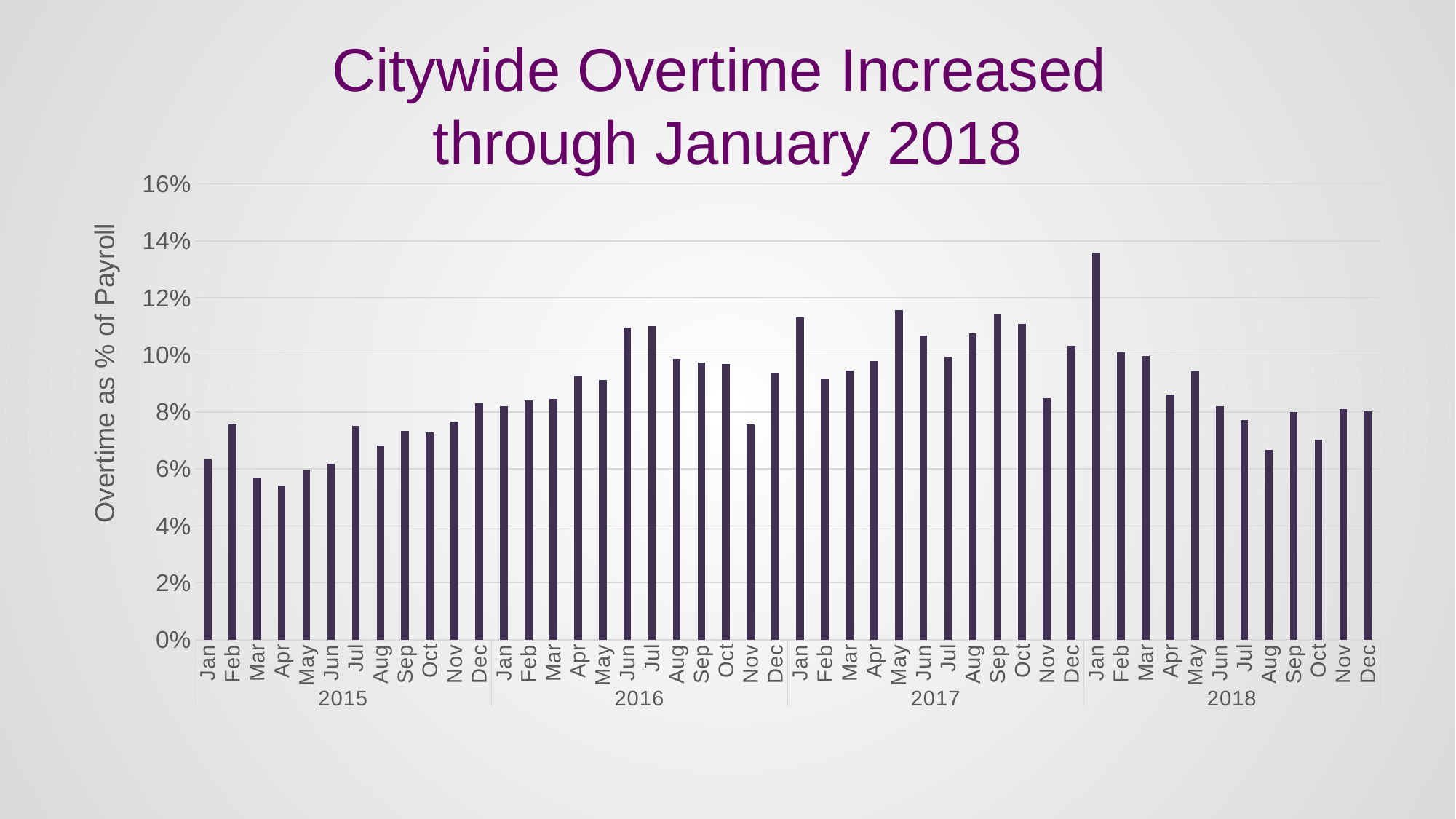
Which month has the highest overtime as a percentage of payroll? Jan 2018 What kind of chart is shown on the slide? Bar chart Which month has the lowest overtime as a percentage of payroll? Apr 2015 How many monthly bars are plotted on the chart? 48 Which is larger, the value for Jan 2017 or the value for Jan 2018? Jan 2018 Is the value for Jan 2018 greater or less than 12%? greater Is the value for May 2017 greater or less than 10%? greater Which is larger, the value for Apr 2015 or the value for Apr 2016? Apr 2016 What is the label on the vertical axis of the chart? Overtime as % of Payroll Is the value for Nov 2016 greater or less than 8%? less Do the values generally rise or fall from Jan 2018 to Dec 2018? Fall